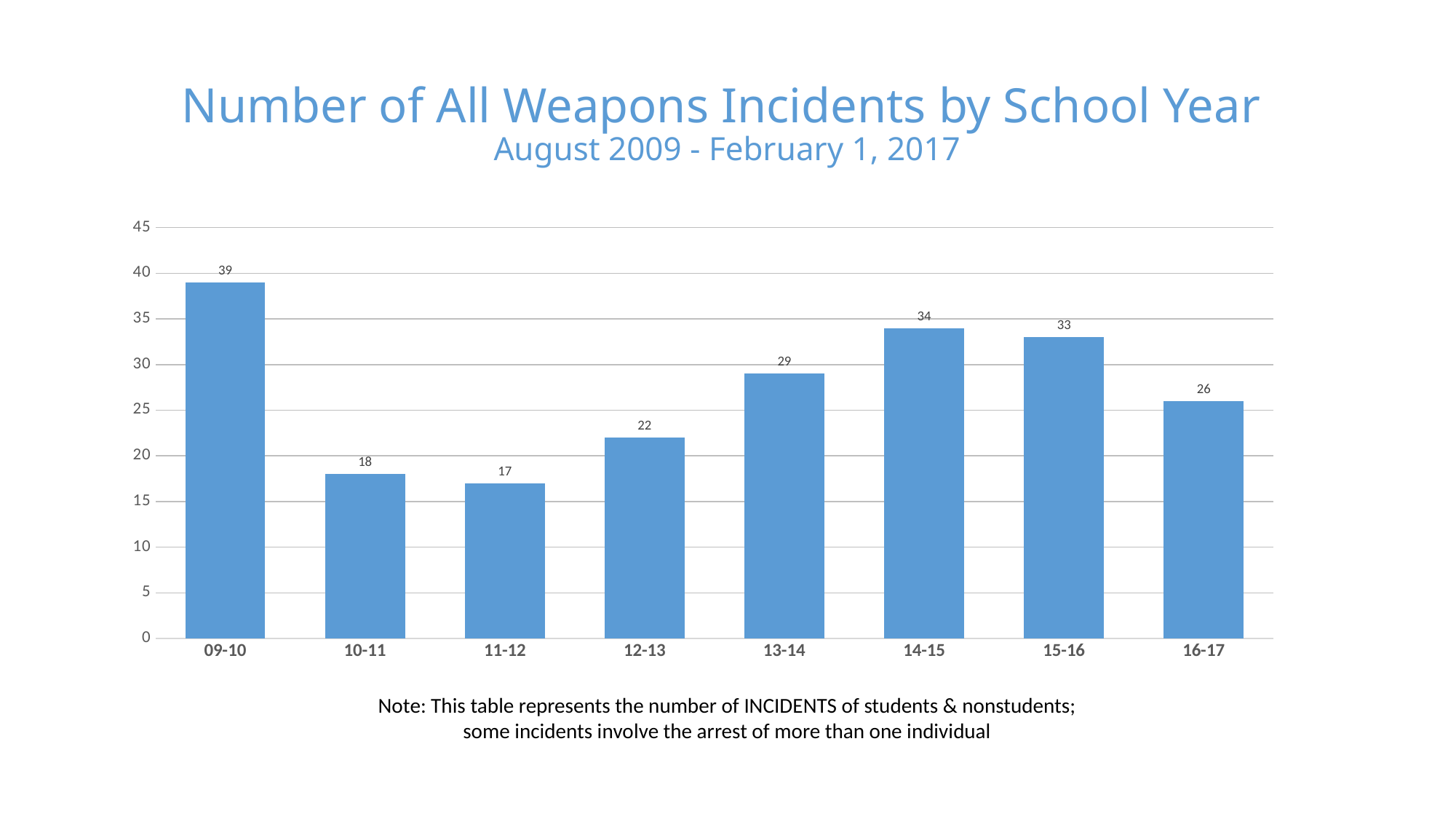
What is the number of weapons incidents for the 16-17 school year? 26 What is the difference in weapons incidents between the 09-10 and 10-11 school years? 21 What is the number of weapons incidents for the 13-14 school year? 29 What is the number of weapons incidents for the 09-10 school year? 39 Which school year has the lowest number of weapons incidents? 11-12 How many school years are shown on the chart? 8 What is the title of the chart? Number of All Weapons Incidents by School Year Which school year has the highest number of weapons incidents? 09-10 What is the difference in weapons incidents between the 14-15 and 16-17 school years? 8 Is the value for the 13-14 school year greater or less than 25? greater Which school year had more weapons incidents, 12-13 or 15-16? 15-16 What kind of chart is shown on the slide? Bar chart